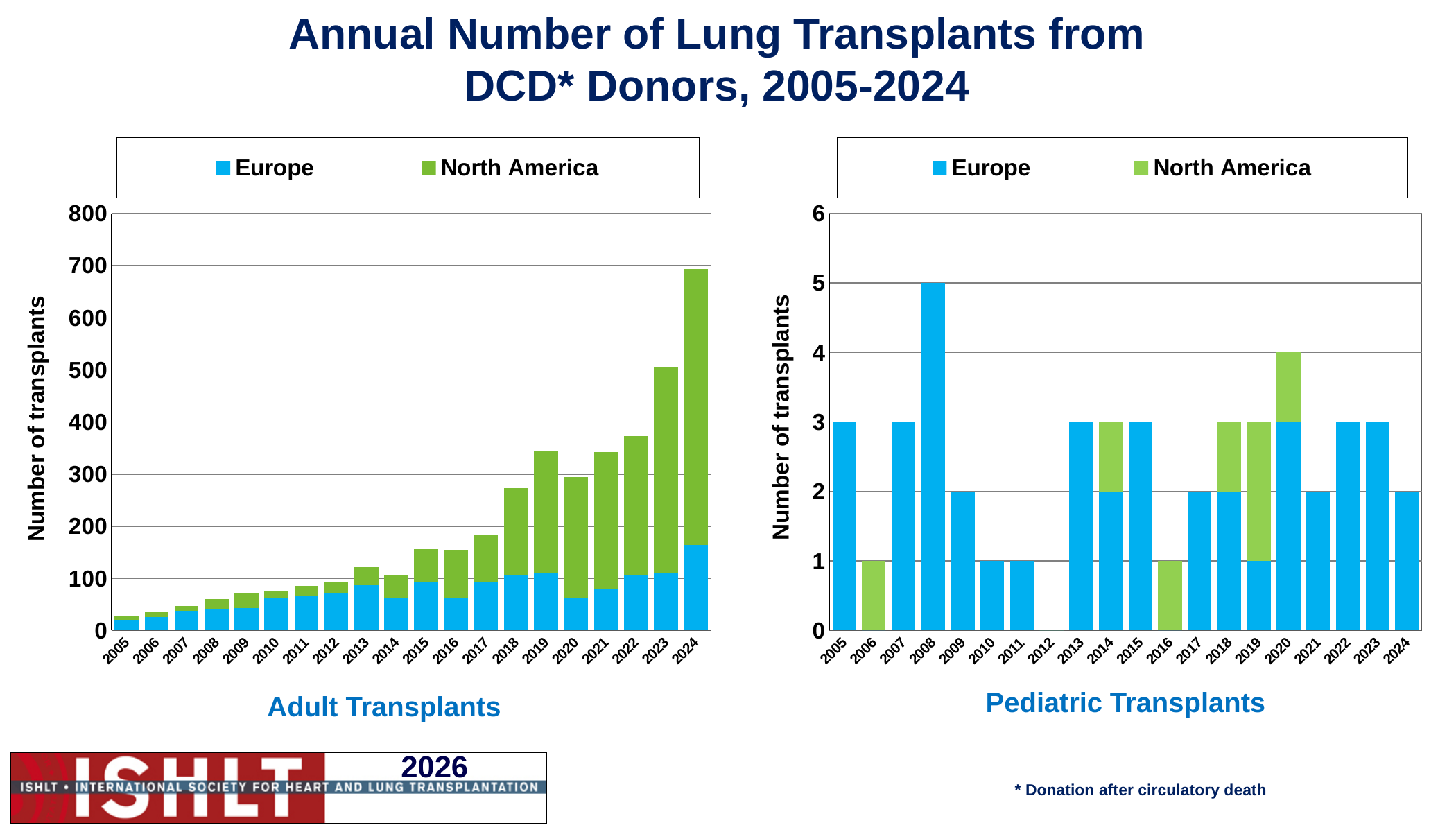
In the Adult Transplants chart, is the total value for 2024 greater or less than 600? greater In the Adult Transplants chart, which year has the highest total number of transplants? 2024 What type of chart is the Pediatric Transplants chart? Stacked bar chart In the Adult Transplants chart, is the total value for 2005 greater or less than 100? less In the Adult Transplants chart, is the total value for 2019 greater or less than 300? greater In the Pediatric Transplants chart, how many series does the legend list? 2 In the Adult Transplants chart, which is larger, the total for 2023 or the total for 2022? 2023 In the Pediatric Transplants chart, what is the value for North America in 2020? 1 In the Pediatric Transplants chart, which year has the highest total number of transplants? 2008 In the Adult Transplants chart, how many years are shown on the x axis? 20 In the Pediatric Transplants chart, what is the total number of transplants in 2008? 5 In the Pediatric Transplants chart, what is the value for Europe in 2019? 1